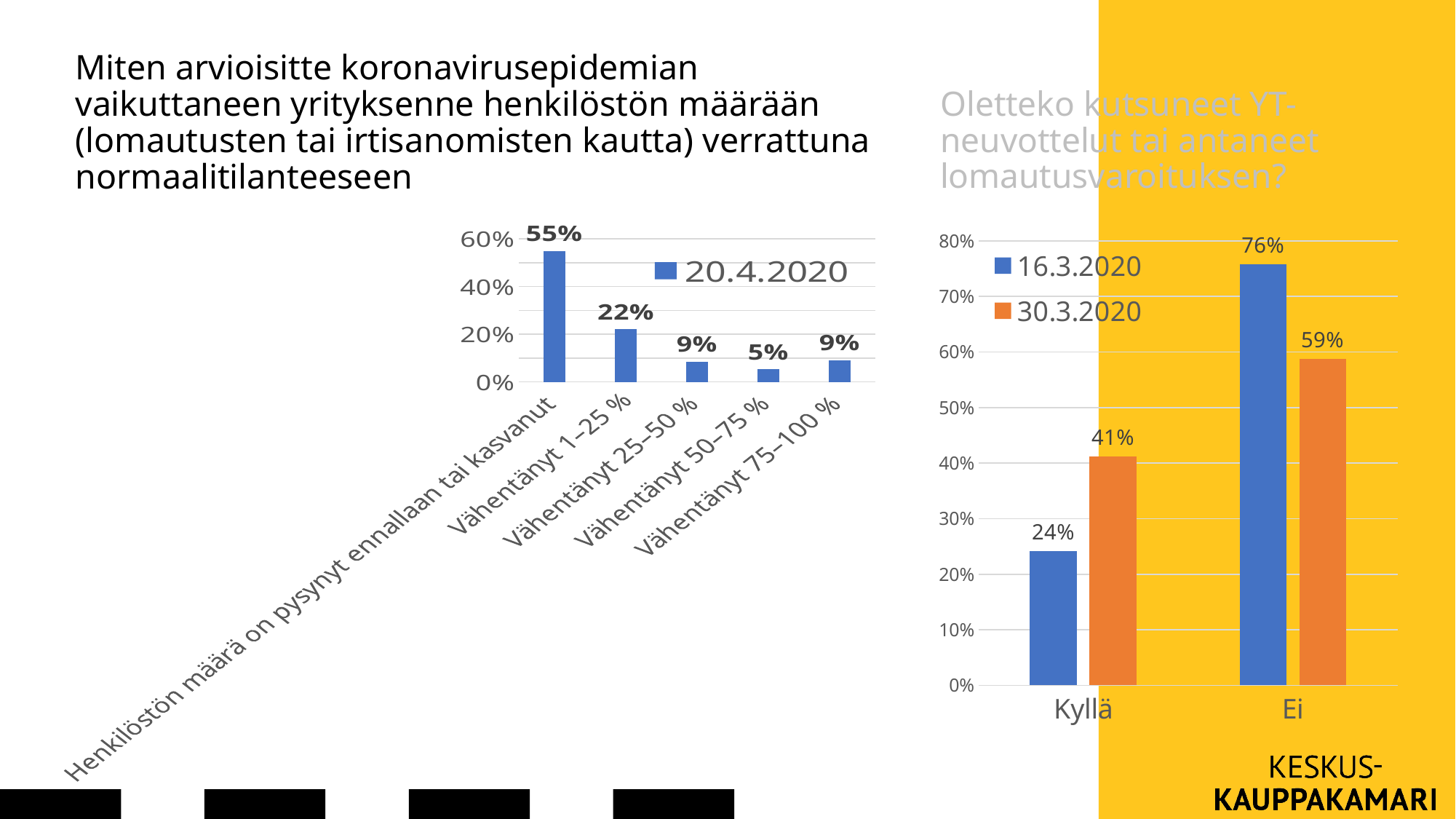
In the left chart about the effect on personnel numbers, what is the value for 'Vähentänyt 1–25 %'? 22% In the left chart about the effect on personnel numbers, what is the value for 'Henkilöstön määrä on pysynyt ennallaan tai kasvanut'? 55% In the right chart 'Oletteko kutsuneet YT-neuvottelut tai antaneet lomautusvaroituksen?', what is the value for Kyllä on 30.3.2020? 41% In the right chart 'Oletteko kutsuneet YT-neuvottelut tai antaneet lomautusvaroituksen?', what is the value for Ei on 16.3.2020? 76% In the right chart 'Oletteko kutsuneet YT-neuvottelut tai antaneet lomautusvaroituksen?', how many series does the legend list? 2 In the left chart about the effect on personnel numbers, which category has the lowest value? Vähentänyt 50–75 % In the left chart about the effect on personnel numbers, what date does the legend show? 20.4.2020 What kind of chart is the right chart 'Oletteko kutsuneet YT-neuvottelut tai antaneet lomautusvaroituksen?'? Bar chart In the right chart 'Oletteko kutsuneet YT-neuvottelut tai antaneet lomautusvaroituksen?', which is larger for Ei: 16.3.2020 or 30.3.2020? 16.3.2020 In the left chart about the effect on personnel numbers, how many categories are shown? 5 In the left chart about the effect on personnel numbers, what is the difference between 'Vähentänyt 1–25 %' and 'Vähentänyt 25–50 %'? 13% In the right chart 'Oletteko kutsuneet YT-neuvottelut tai antaneet lomautusvaroituksen?', what is the difference between the Kyllä values for 30.3.2020 and 16.3.2020? 17%